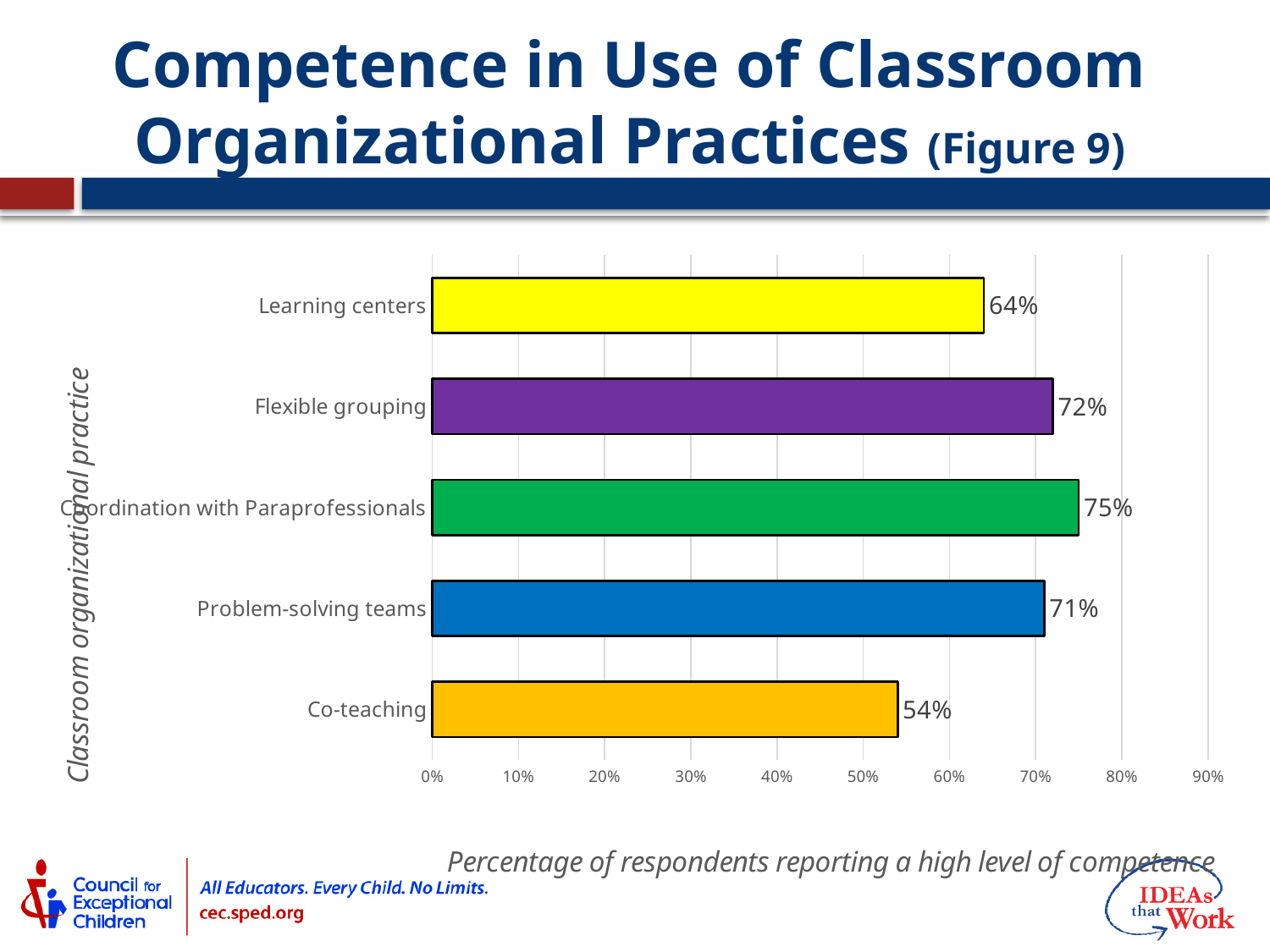
What is the value shown for Co-teaching? 54% How many classroom organizational practices are shown in the chart? 5 What is the value shown for Flexible grouping? 72% Which has a larger value, Learning centers or Problem-solving teams? Problem-solving teams What kind of chart is shown on the slide? Bar chart What is the label of the vertical axis of the chart? Classroom organizational practice Is the value for Co-teaching greater or less than 60%? less What percentage of respondents reported a high level of competence in Learning centers? 64% Which classroom organizational practice has the highest percentage? Coordination with Paraprofessionals Which classroom organizational practice has the lowest percentage? Co-teaching What is the difference between the values for Flexible grouping and Problem-solving teams? 1% What is the difference between the values for Coordination with Paraprofessionals and Co-teaching? 21%